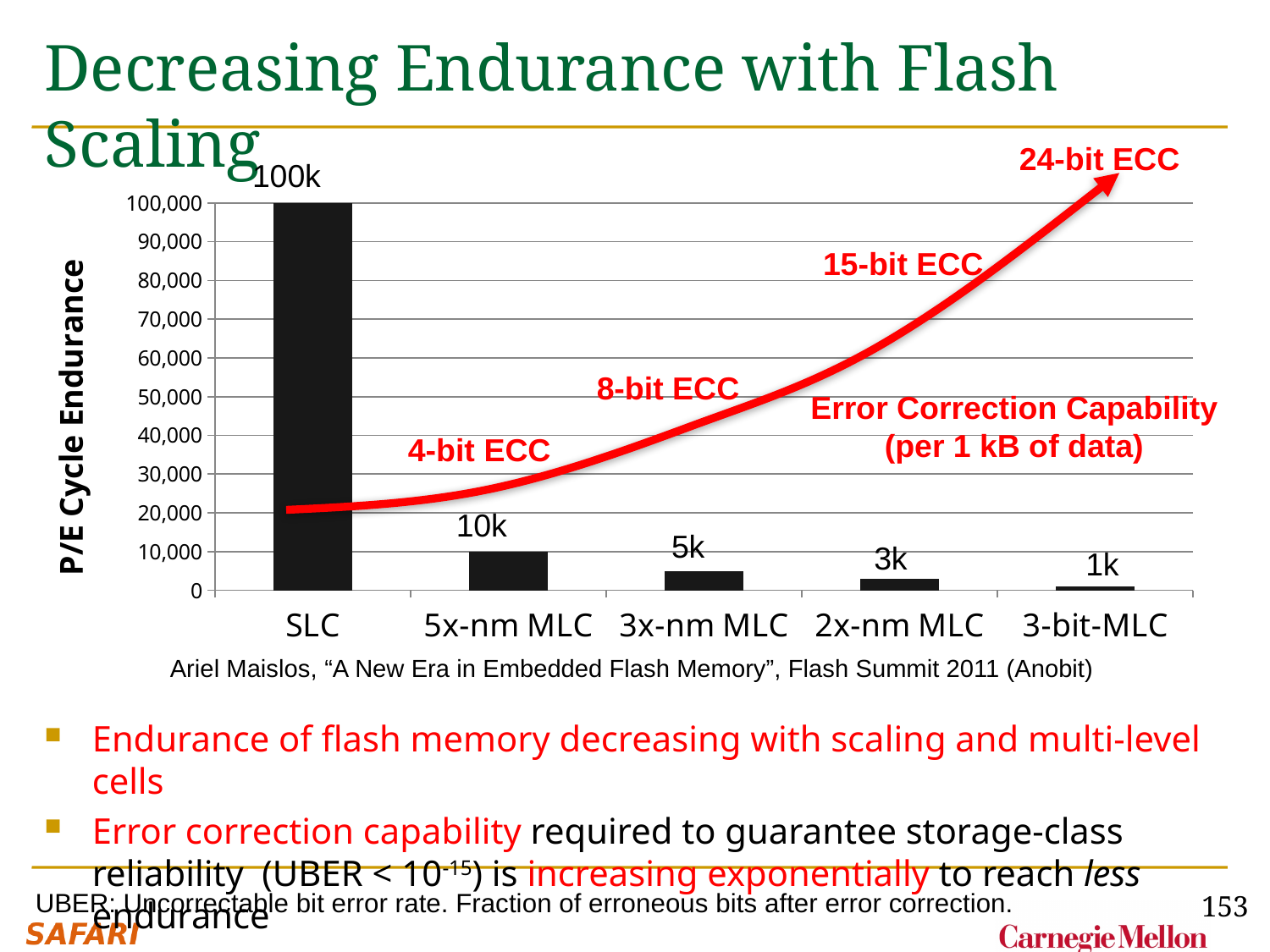
What is the difference in P/E cycle endurance between SLC and 5x-nm MLC? 90k What kind of chart is used to show P/E cycle endurance? bar chart How many categories are shown on the x axis of the chart? 5 What is the P/E cycle endurance shown for 5x-nm MLC? 10k Which category has the lowest P/E cycle endurance? 3-bit-MLC What is the P/E cycle endurance shown for SLC? 100k What is the P/E cycle endurance shown for 3-bit-MLC? 1k Which has a higher P/E cycle endurance, 3x-nm MLC or 2x-nm MLC? 3x-nm MLC Is the value for SLC greater or less than 50,000? greater What is the difference in P/E cycle endurance between 3x-nm MLC and 2x-nm MLC? 2k Do the P/E cycle endurance values rise or fall from left to right along the x axis? fall Which category has the highest P/E cycle endurance? SLC